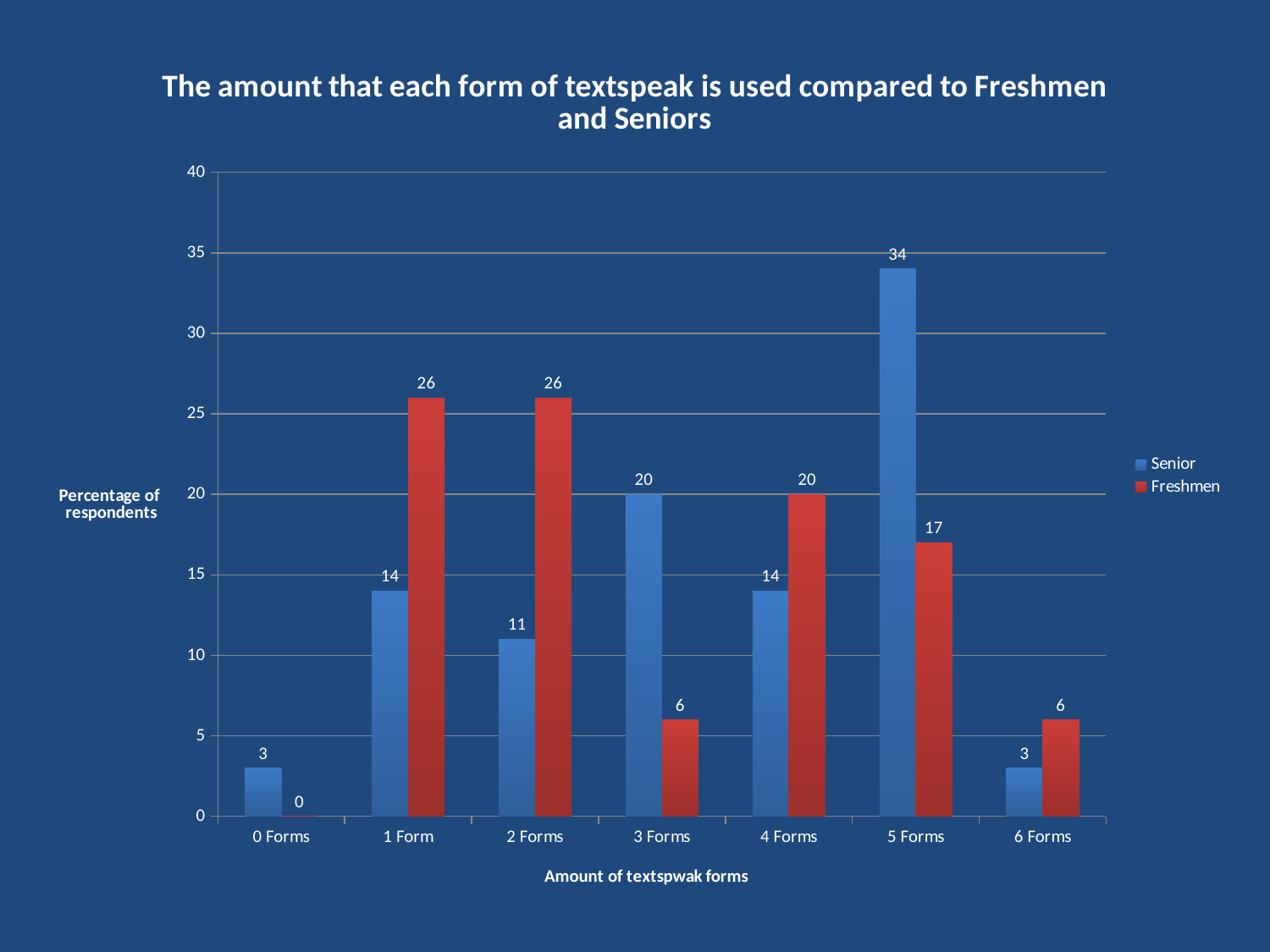
Which category has the lowest Freshmen value? 0 Forms Which category has the highest Senior value? 5 Forms How many series does the legend list? 2 What is the difference between the Senior and Freshmen values for 5 Forms? 17 What is the difference between the Freshmen values for 1 Form and 3 Forms? 20 How many categories are shown on the x axis? 7 What is the label of the y axis? Percentage of respondents What is the Freshmen value for 1 Form? 26 What kind of chart is shown on the slide? Bar chart Which is larger for 2 Forms, the Senior value or the Freshmen value? Freshmen What is the Freshmen value for 0 Forms? 0 What is the Senior value for 5 Forms? 34